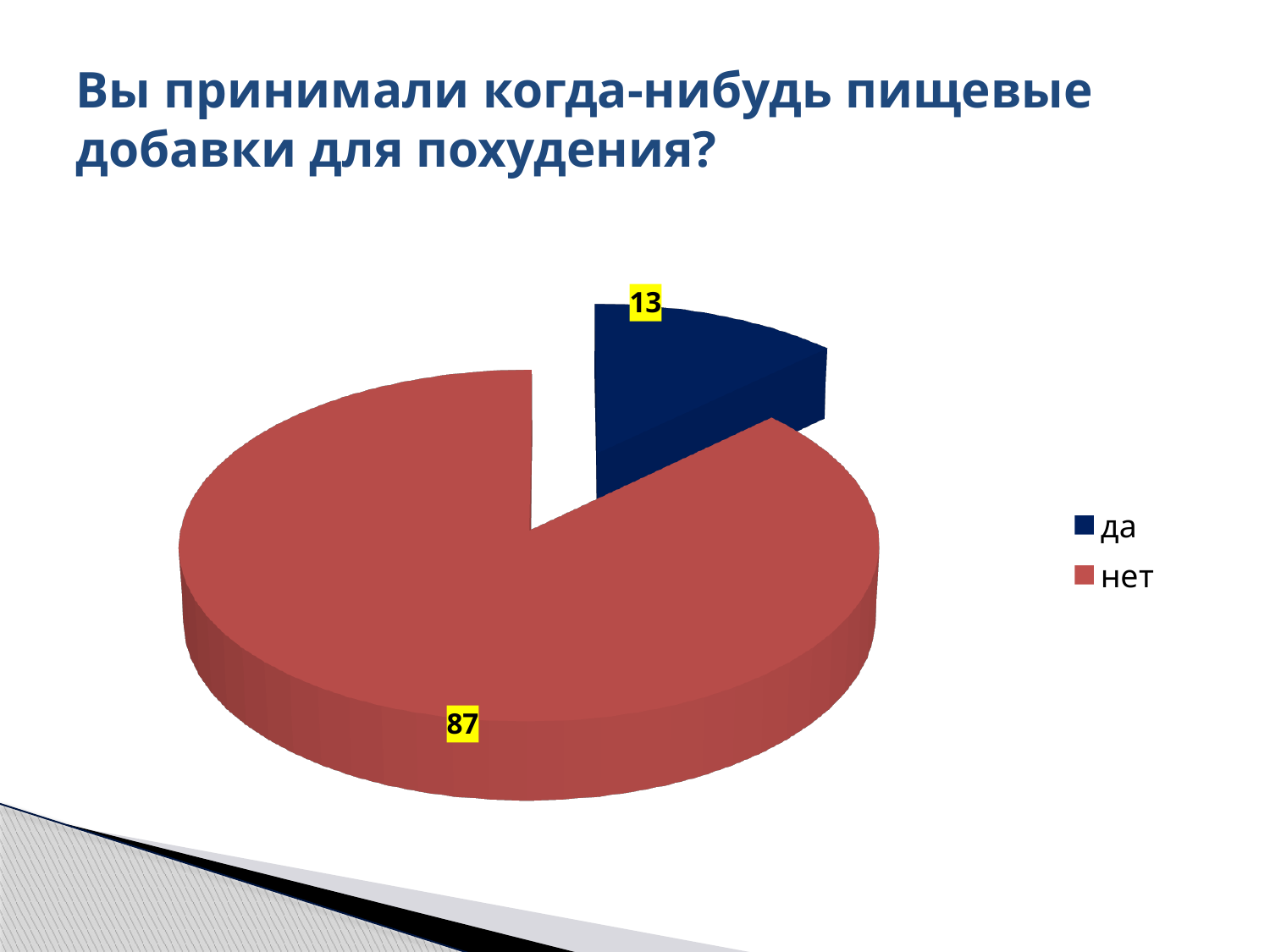
What value is shown for the "нет" slice? 87 What share of the pie does the "да" slice represent? 13% Which is larger, the value for "да" or the value for "нет"? нет Which category has the largest slice of the pie? нет What is the difference between the values for "нет" and "да"? 74 What value is shown for the "да" slice? 13 Which category has the smallest slice of the pie? да How many entries does the legend list? 2 What is the total of the two slice values? 100 What colour is the "нет" slice? red What kind of chart is shown on the slide? pie chart How many slices does the pie chart have? 2